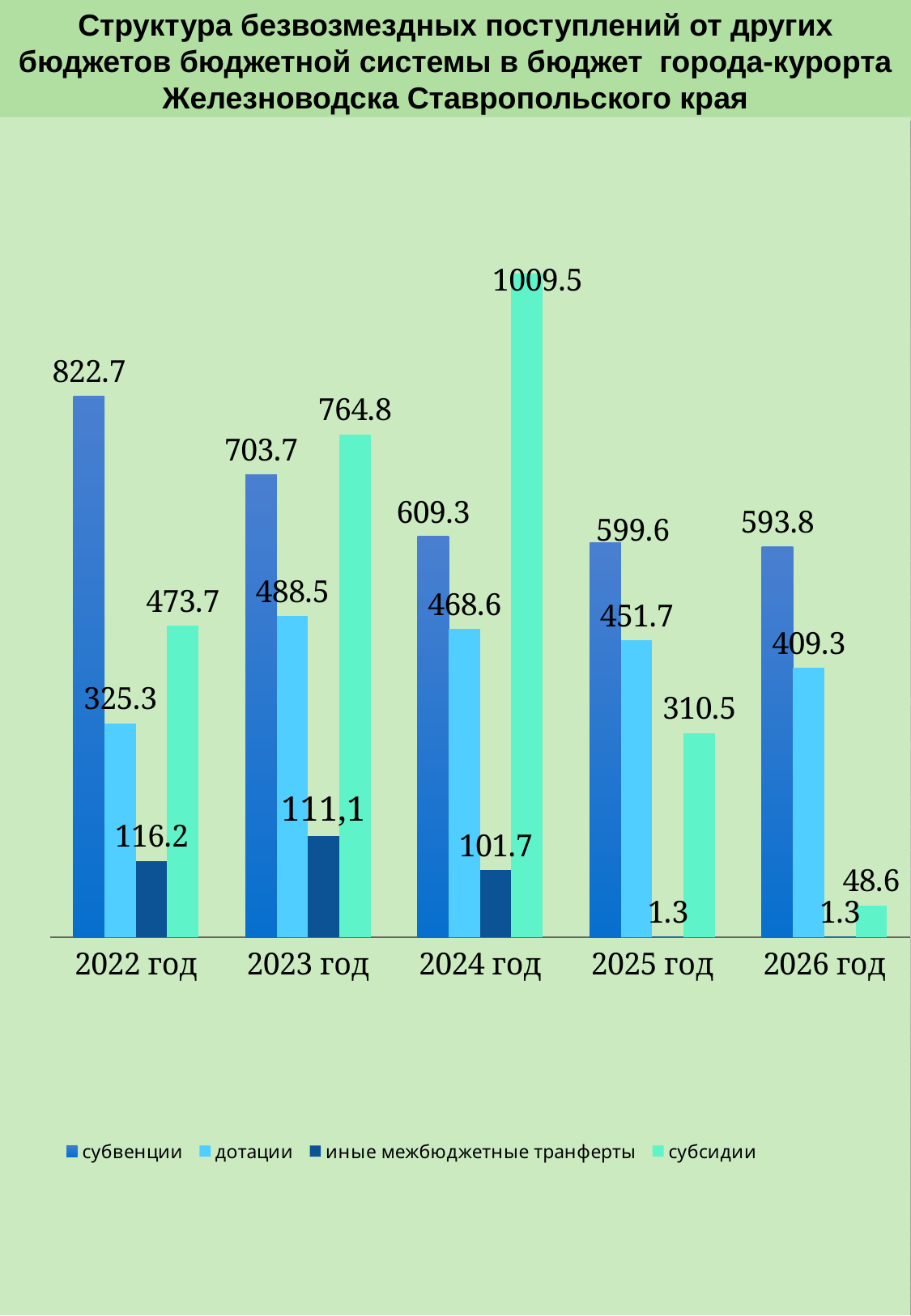
What is the value of иные межбюджетные транферты for 2023 год? 111,1 How many series does the legend list? 4 What kind of chart is shown on the slide? bar chart What is the difference between субвенции in 2022 год and 2023 год? 119.0 Which is larger in 2025 год: субвенции or субсидии? субвенции Do the субвенции values rise or fall from 2022 год to 2026 год? fall In which year is the субсидии value highest? 2024 год How many years are shown on the x axis? 5 In which year is the субвенции value lowest? 2026 год What is the value of субвенции for 2022 год? 822.7 What is the value of дотации for 2026 год? 409.3 What is the value of субсидии for 2024 год? 1009.5